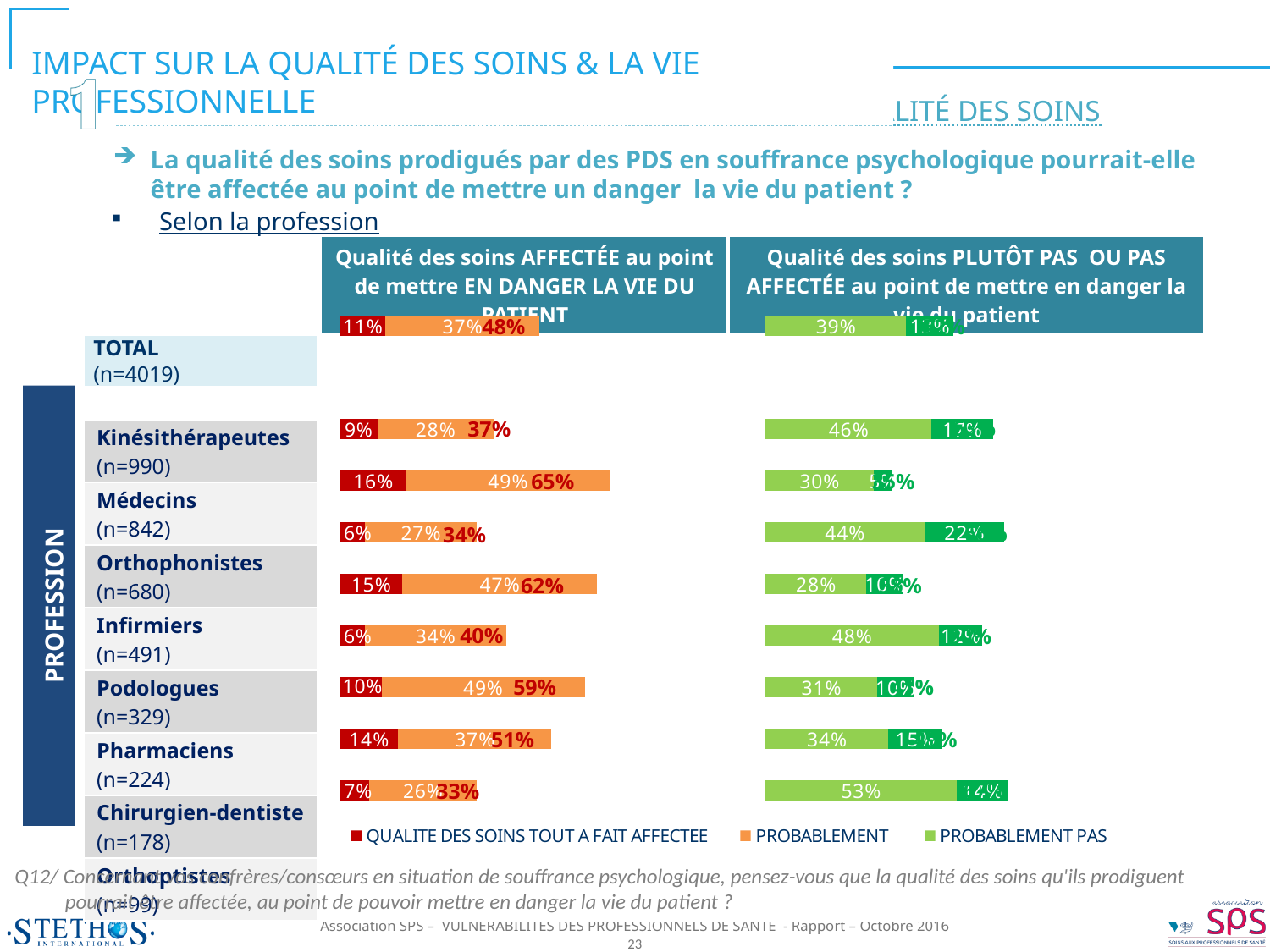
What is the 'QUALITE DES SOINS TOUT A FAIT AFFECTEE' value for Kinésithérapeutes? 9% How many series does the legend list? 3 What is the 'PROBABLEMENT PAS' value for the TOTAL row? 39% How many professions are listed in the chart (excluding TOTAL)? 8 What is the 'PROBABLEMENT' value for the TOTAL row? 37% Which legend entry is shown in red? QUALITE DES SOINS TOUT A FAIT AFFECTEE What kind of chart is shown on the slide? bar chart What is the combined 'Qualité des soins AFFECTÉE' percentage for the TOTAL row? 48% What is the combined 'Qualité des soins AFFECTÉE' percentage for Médecins? 65% What is the highest combined 'Qualité des soins AFFECTÉE' percentage among the professions? 65% What is the 'QUALITE DES SOINS TOUT A FAIT AFFECTEE' value for the TOTAL row? 11% Which profession has the highest 'QUALITE DES SOINS TOUT A FAIT AFFECTEE' value? Médecins